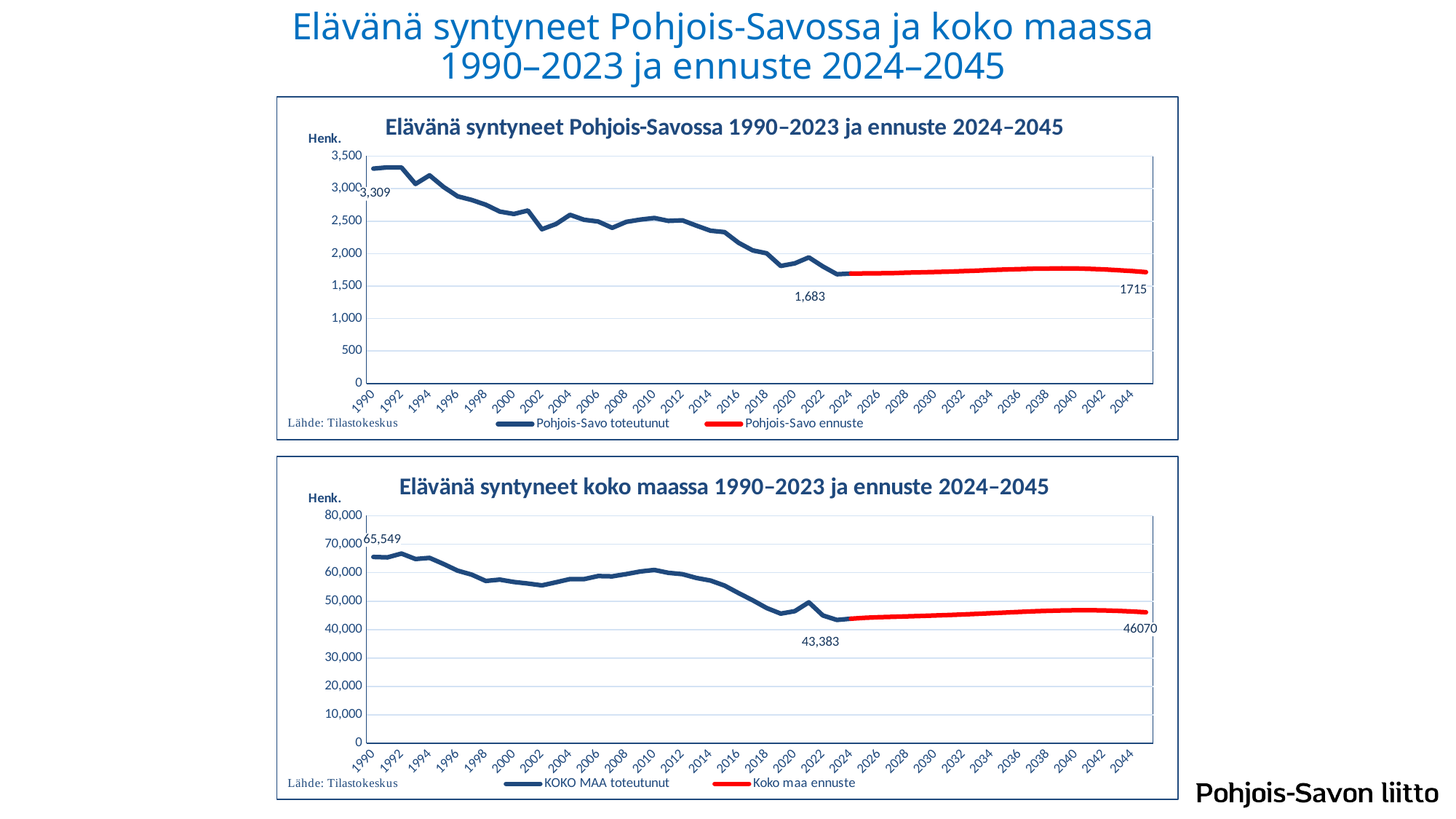
In the bottom chart (Elävänä syntyneet koko maassa), what is the value for 2023? 43,383 In the bottom chart (Elävänä syntyneet koko maassa), is the value for 2010 greater or less than 50,000? greater In the top chart (Elävänä syntyneet Pohjois-Savossa), what is the difference between the 1990 value and the 2023 value? 1,626 In the top chart (Elävänä syntyneet Pohjois-Savossa), what is the value for 1990? 3,309 What type of chart is the top chart (Elävänä syntyneet Pohjois-Savossa)? line chart In the bottom chart (Elävänä syntyneet koko maassa), how many series does the legend list? 2 In the bottom chart (Elävänä syntyneet koko maassa), what is the value for 1990? 65,549 In the bottom chart (Elävänä syntyneet koko maassa), what is the forecast value for 2045? 46070 In the top chart (Elävänä syntyneet Pohjois-Savossa), what is the forecast value for 2045? 1715 In the top chart (Elävänä syntyneet Pohjois-Savossa), what is the value for 2023? 1,683 In the top chart (Elävänä syntyneet Pohjois-Savossa), is the value for 2010 greater or less than 2,000? greater In the bottom chart (Elävänä syntyneet koko maassa), what is the difference between the 1990 value and the 2023 value? 22,166